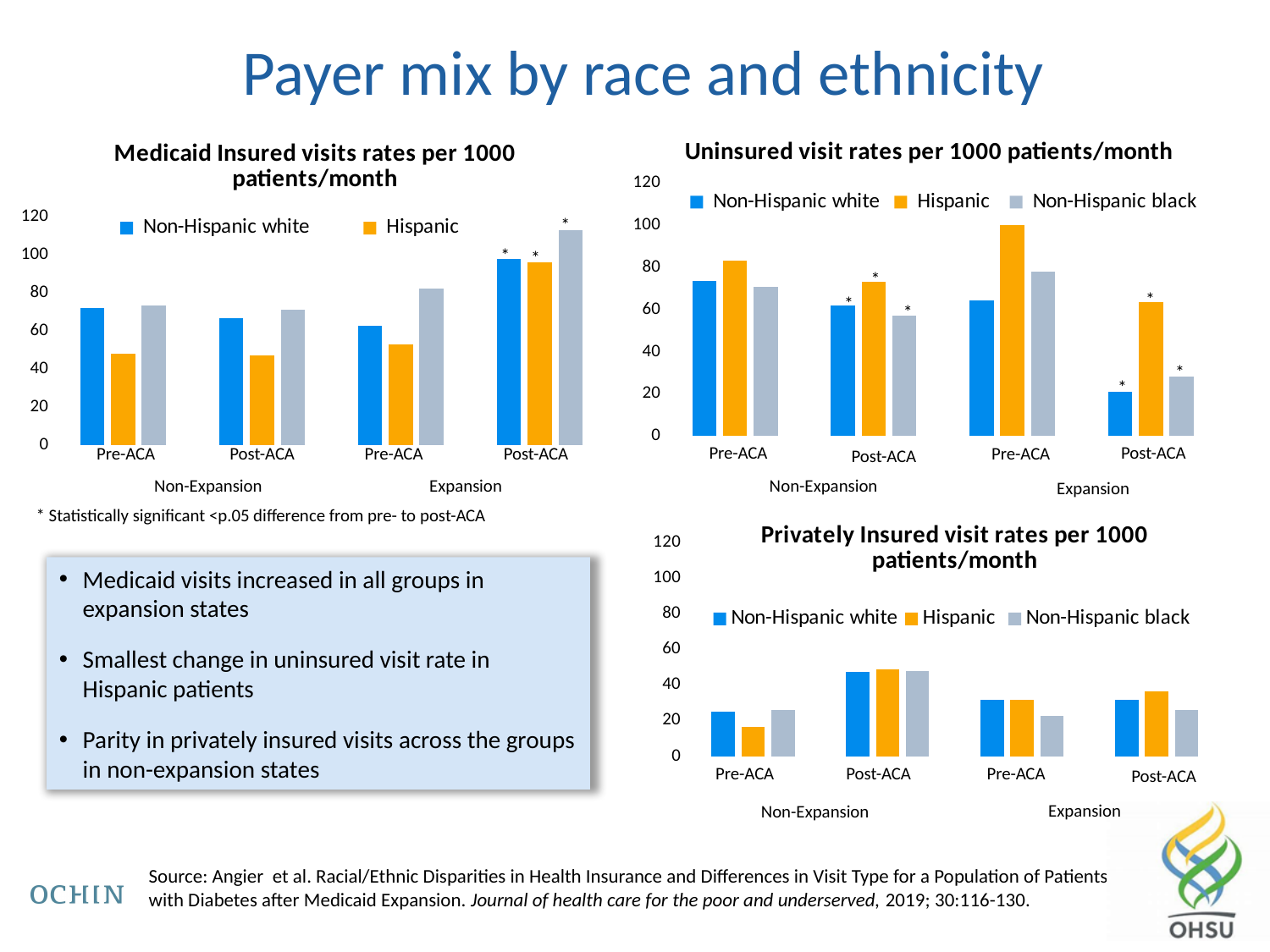
In the 'Uninsured visit rates per 1000 patients/month' chart, how many series does the legend list? 3 In the 'Medicaid Insured visits rates per 1000 patients/month' chart, is the value for Non-Hispanic black at Post-ACA in Expansion states greater or less than 100? greater In the 'Privately Insured visit rates per 1000 patients/month' chart, is the value for Non-Hispanic white at Post-ACA in Non-Expansion states greater or less than 40? greater In the 'Uninsured visit rates per 1000 patients/month' chart, is the value for Non-Hispanic white at Post-ACA in Expansion states greater or less than 40? less In the 'Uninsured visit rates per 1000 patients/month' chart, which group has the highest value for Pre-ACA in Expansion states? Hispanic How many categories are shown on the x axis of the 'Privately Insured visit rates per 1000 patients/month' chart? 4 What kind of chart is the 'Medicaid Insured visits rates per 1000 patients/month' chart? bar chart In the 'Uninsured visit rates per 1000 patients/month' chart, does the Hispanic value rise or fall from Pre-ACA to Post-ACA in Expansion states? fall In the 'Medicaid Insured visits rates per 1000 patients/month' chart, at Pre-ACA in Non-Expansion states, which is larger: Non-Hispanic white or Hispanic? Non-Hispanic white